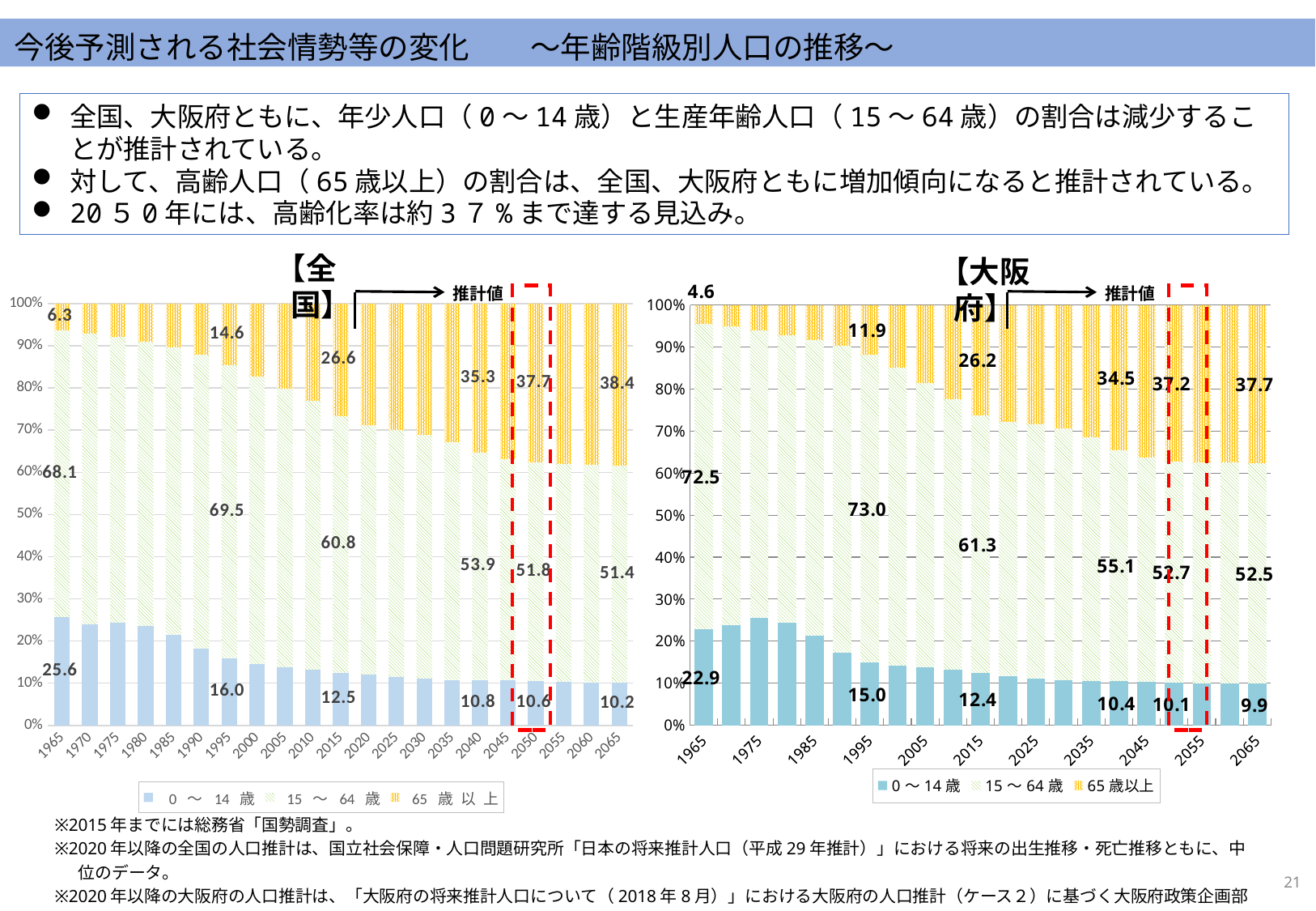
In the 【全国】 chart, what is the value for 0～14歳 in 2050? 10.6 In the 【全国】 chart, what is the difference between the 65歳以上 value in 2065 and in 1965? 32.1 In the 【全国】 chart, is the 0～14歳 share in 1990 greater or less than 20%? less Which is larger for 65歳以上 in 2065: the 【全国】 chart value or the 【大阪府】 chart value? 【全国】 (38.4) In the 【大阪府】 chart, what is the value for 0～14歳 in 1965? 22.9 In the 【全国】 chart, what is the value for 65歳以上 in 2065? 38.4 In the 【大阪府】 chart, what is the value for 15～64歳 in 2065? 52.5 How many series does the legend of the 【大阪府】 chart list? 3 In the 【全国】 chart, does the share of 0～14歳 rise or fall from 1965 to 2065? Fall How many years (bars) are shown on the x axis of the 【全国】 chart? 21 In the 【全国】 chart, what is the value for 65歳以上 in 1965? 6.3 What kind of chart is the 【全国】 chart on the left? Stacked bar chart